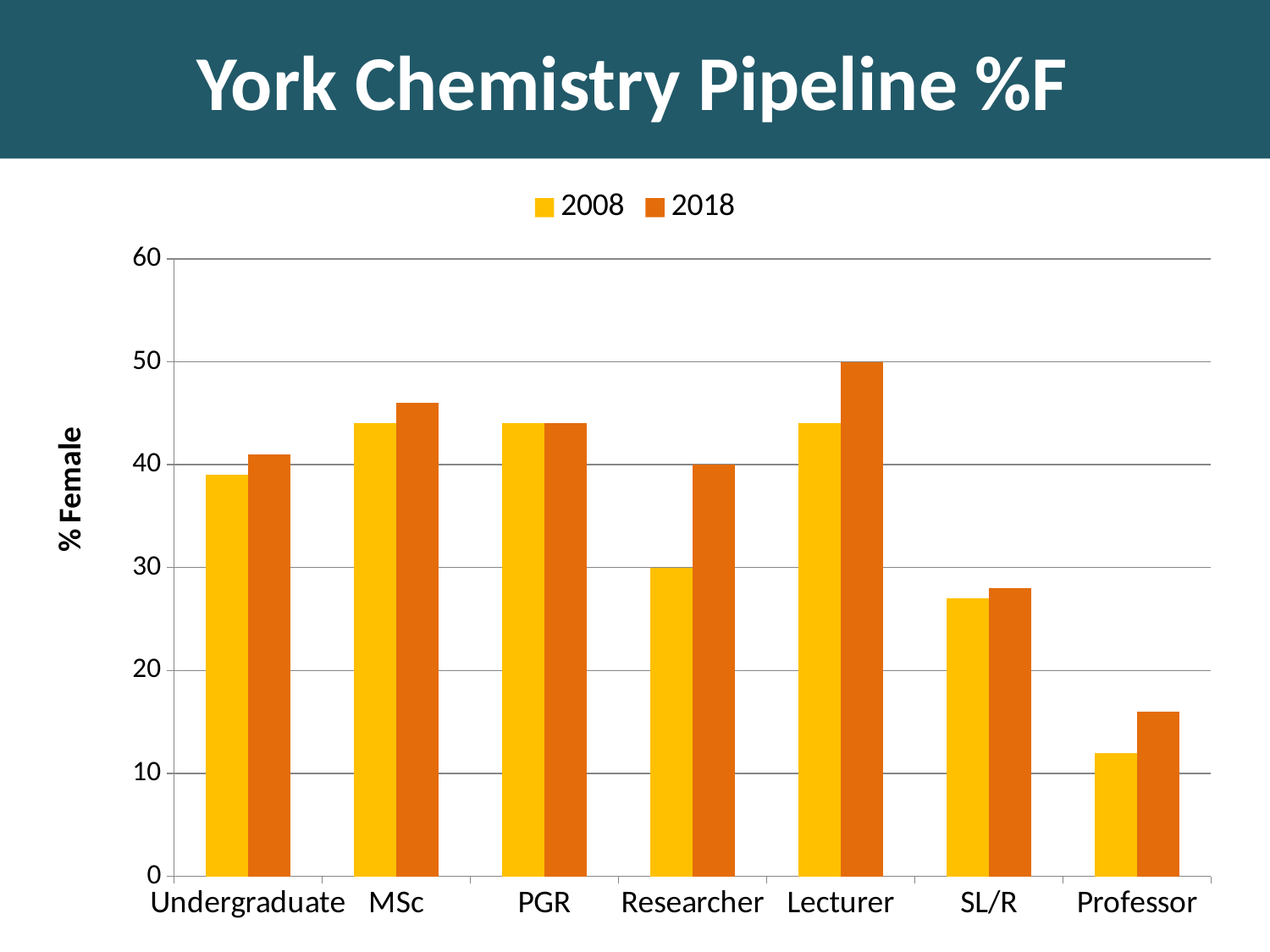
Which is larger for SL/R, the 2008 value or the 2018 value? 2018 What is the difference between the 2018 and 2008 values for Researcher? 10 Is the 2008 value for Professor greater or less than 20? less How many categories are shown on the x axis? 7 What is the 2018 value for Lecturer? 50 What type of chart is shown on the slide? bar chart Which category has the highest 2018 value? Lecturer What is the 2008 value for Researcher? 30 Is the 2018 value for MSc greater or less than 40? greater How many series does the legend list? 2 Which category has the lowest 2008 value? Professor What is the 2018 value for Researcher? 40